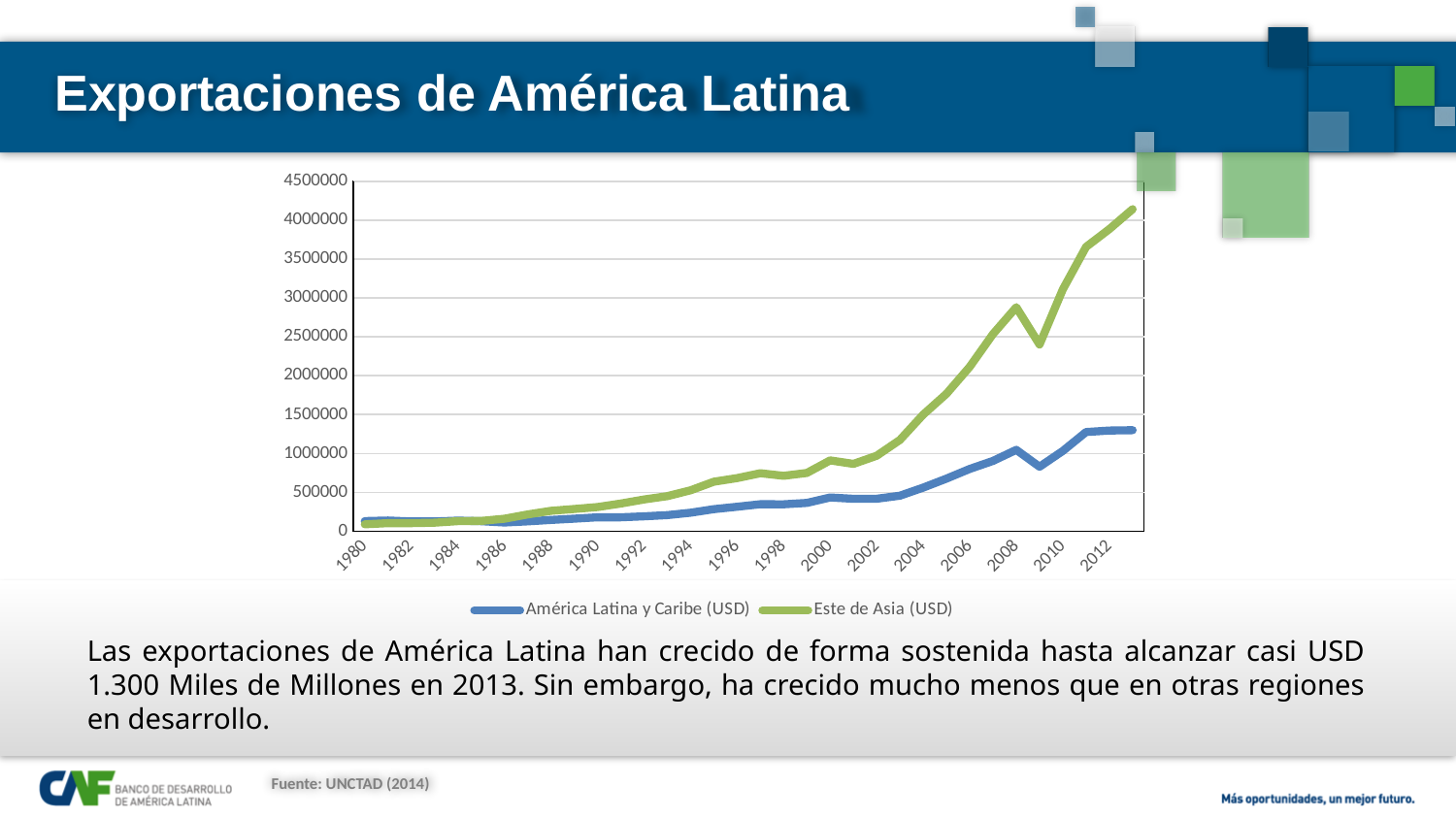
Is the value for América Latina y Caribe in 2012 greater or less than 1000000? greater Overall, do the values for Este de Asia rise or fall from 1980 to 2012? rise How many series does the legend list? 2 What kind of chart is shown on the slide? line chart Is the value for Este de Asia in 2008 greater or less than 2500000? greater Which series reaches the highest value on the chart? Este de Asia (USD) What are the two series named in the legend? América Latina y Caribe (USD) and Este de Asia (USD) In 2012, which series has the larger value, América Latina y Caribe or Este de Asia? Este de Asia What is the title of the slide containing the chart? Exportaciones de América Latina How many year labels are shown on the x axis? 17 Is the value for Este de Asia in 2012 greater or less than 3500000? greater